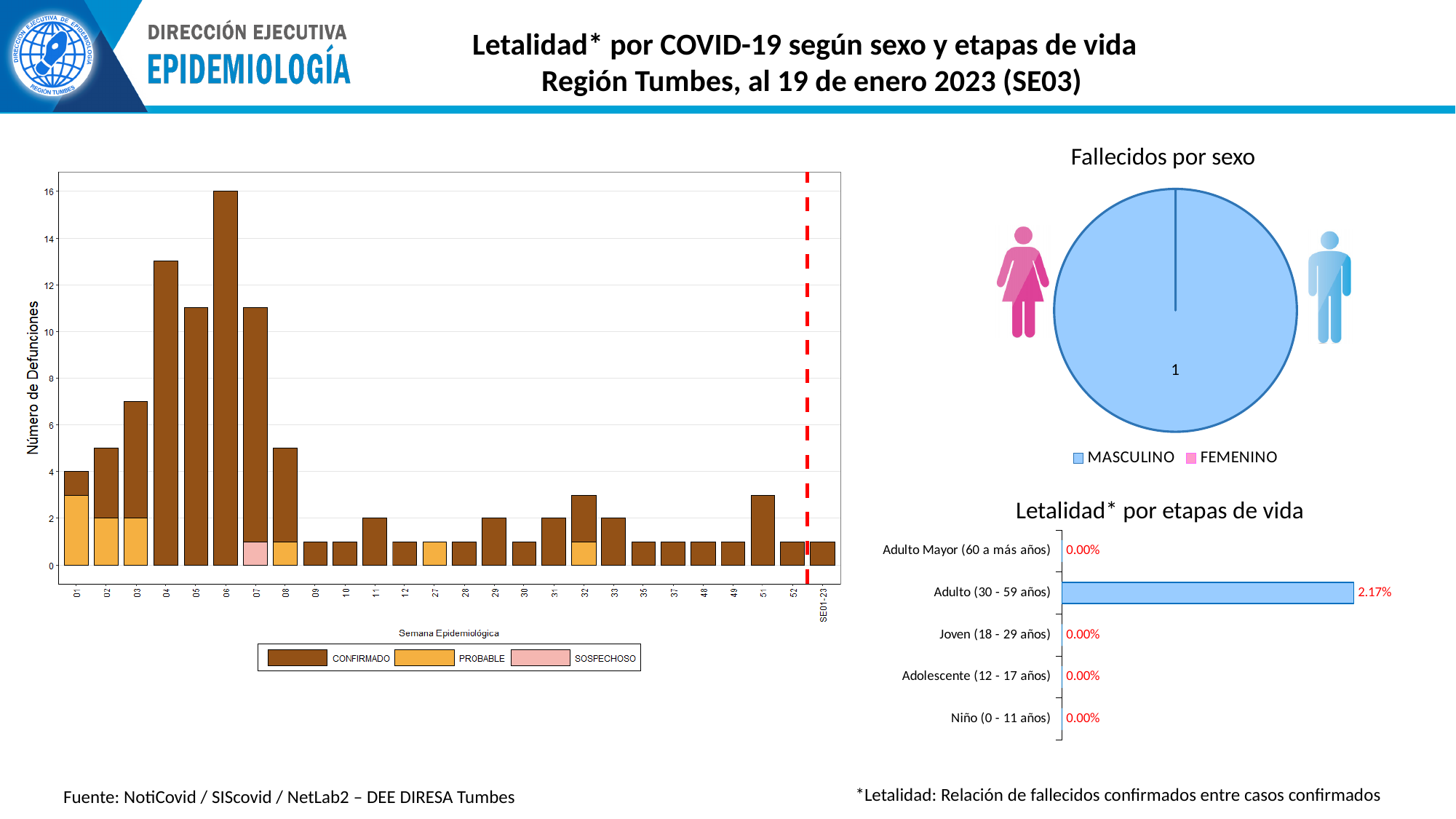
What kind of chart is 'Letalidad* por etapas de vida'? Bar chart In the 'Letalidad* por etapas de vida' chart, what is the value for Joven (18 - 29 años)? 0.00% In the 'Fallecidos por sexo' pie chart, what value is shown for MASCULINO? 1 How many entries does the legend of the 'Fallecidos por sexo' chart list? 2 In the bar chart of deaths by epidemiological week (left), which is larger, the total for week 05 or the total for week 08? Week 05 In the bar chart of deaths by epidemiological week (left), what is the total number of deaths in week 06? 16 In the bar chart of deaths by epidemiological week (left), which week has the highest number of deaths? 06 In the bar chart of deaths by epidemiological week (left), is the total for week 04 greater or less than 12? greater In the 'Letalidad* por etapas de vida' chart, which age group has the highest letalidad? Adulto (30 - 59 años) In the 'Letalidad* por etapas de vida' chart, what is the value for Adulto (30 - 59 años)? 2.17% How many age groups are shown in the 'Letalidad* por etapas de vida' chart? 5 How many series does the legend of the bar chart of deaths by epidemiological week (left) list? 3